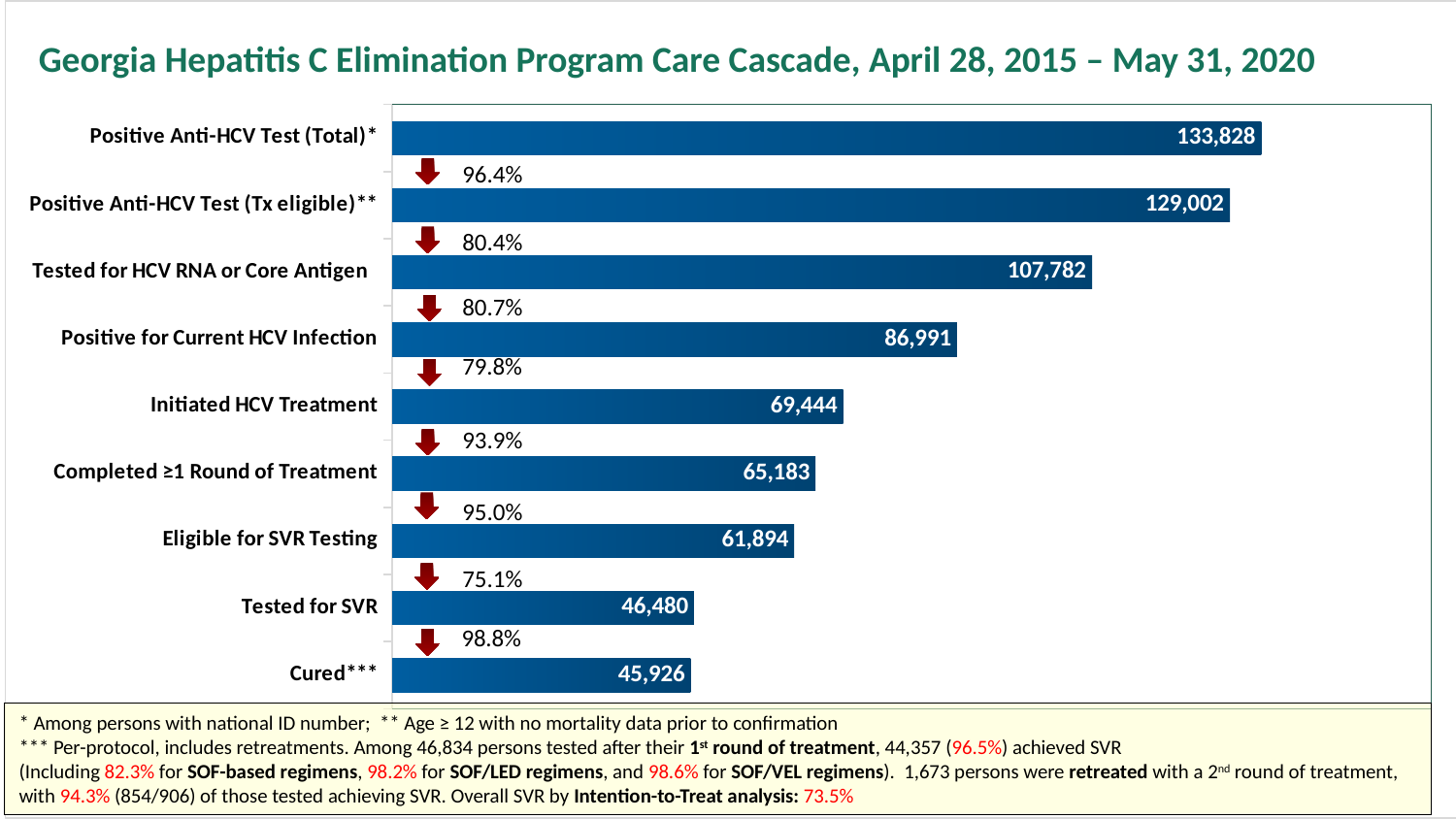
What is the difference between Initiated HCV Treatment and Completed ≥1 Round of Treatment? 4,261 What kind of chart is shown on the slide? bar chart Which is larger, the value for Eligible for SVR Testing or the value for Tested for SVR? Eligible for SVR Testing Do the values rise or fall going down the cascade from the top bar to the bottom bar? fall What is the difference between Tested for SVR and Cured? 554 What is the value for Positive Anti-HCV Test (Total)? 133,828 Which stage has the lowest value? Cured How many stages (categories) are shown in the care cascade chart? 9 Which stage has the highest value? Positive Anti-HCV Test (Total) What is the value for Initiated HCV Treatment? 69,444 What is the value for Tested for HCV RNA or Core Antigen? 107,782 What is the value for Cured? 45,926